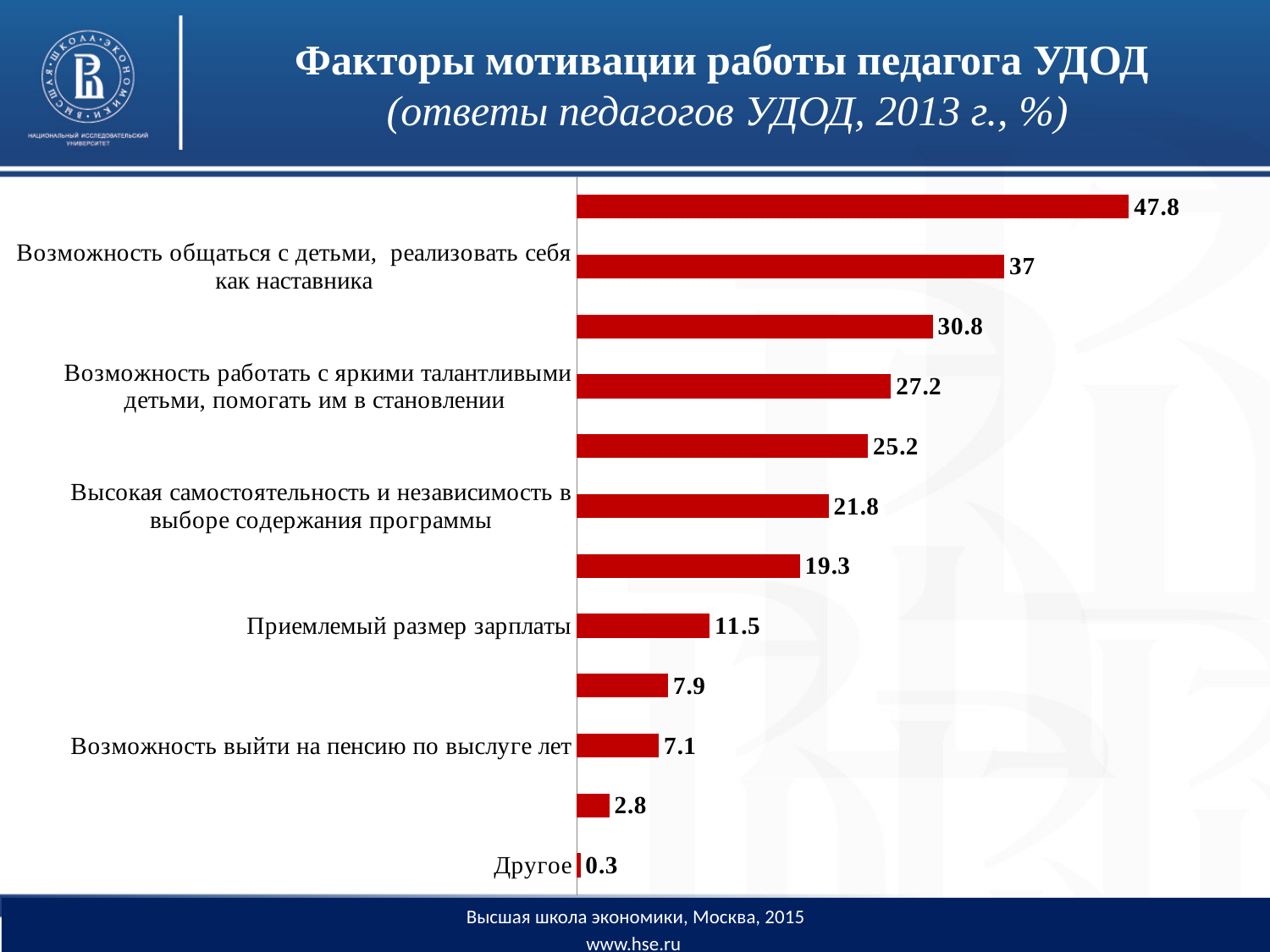
What is the value for "Возможность общаться с детьми, реализовать себя как наставника"? 37 What is the value for "Возможность выйти на пенсию по выслуге лет"? 7.1 What is the value of the longest bar in the chart? 47.8 Which is larger: the value for "Возможность работать с яркими талантливыми детьми, помогать им в становлении" or for "Высокая самостоятельность и независимость в выборе содержания программы"? Возможность работать с яркими талантливыми детьми, помогать им в становлении What is the value for "Высокая самостоятельность и независимость в выборе содержания программы"? 21.8 What year do the survey responses in the chart title refer to? 2013 How many bars are plotted in the chart? 12 What is the value for "Возможность работать с яркими талантливыми детьми, помогать им в становлении"? 27.2 Which category has the lowest value? Другое What type of chart is shown on the slide? bar chart What is the difference between the values for "Приемлемый размер зарплаты" and "Возможность выйти на пенсию по выслуге лет"? 4.4 What is the value for "Приемлемый размер зарплаты"? 11.5